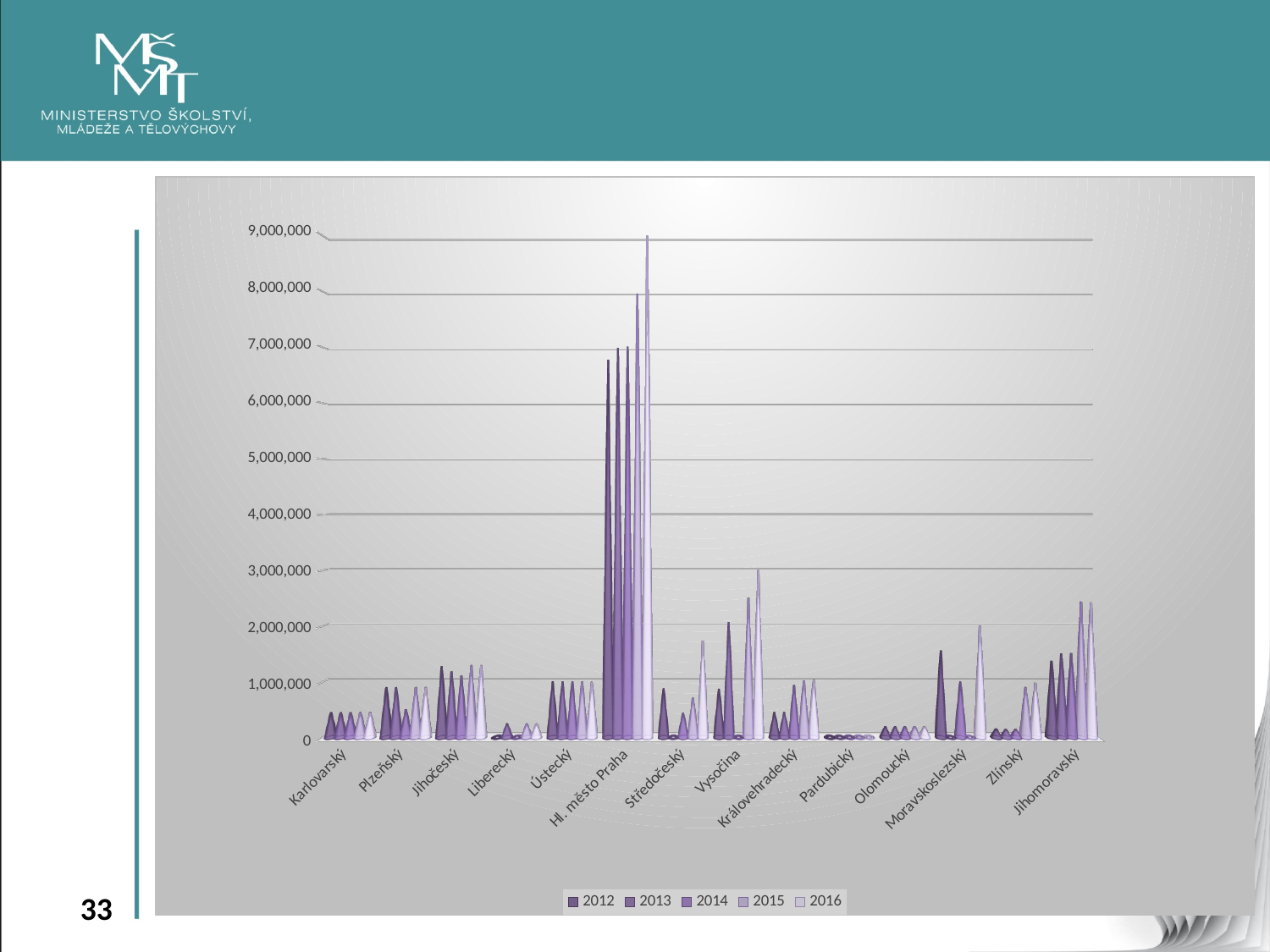
Is the 2016 value for Hl. město Praha greater or less than 8,000,000? greater Is the 2012 value for Liberecký greater or less than 1,000,000? less Which region has the lowest values in the chart? Pardubický How many series does the legend list? 5 How many regions (categories) are shown on the x axis? 14 Which years are listed in the legend? 2012, 2013, 2014, 2015, 2016 For Hl. město Praha, which is larger: the 2012 value or the 2016 value? 2016 What kind of chart is shown on the slide? bar chart Which region has the highest values in the chart? Hl. město Praha Is the 2012 value for Hl. město Praha greater or less than 6,000,000? greater Do the values for Hl. město Praha rise or fall from 2012 to 2016? rise